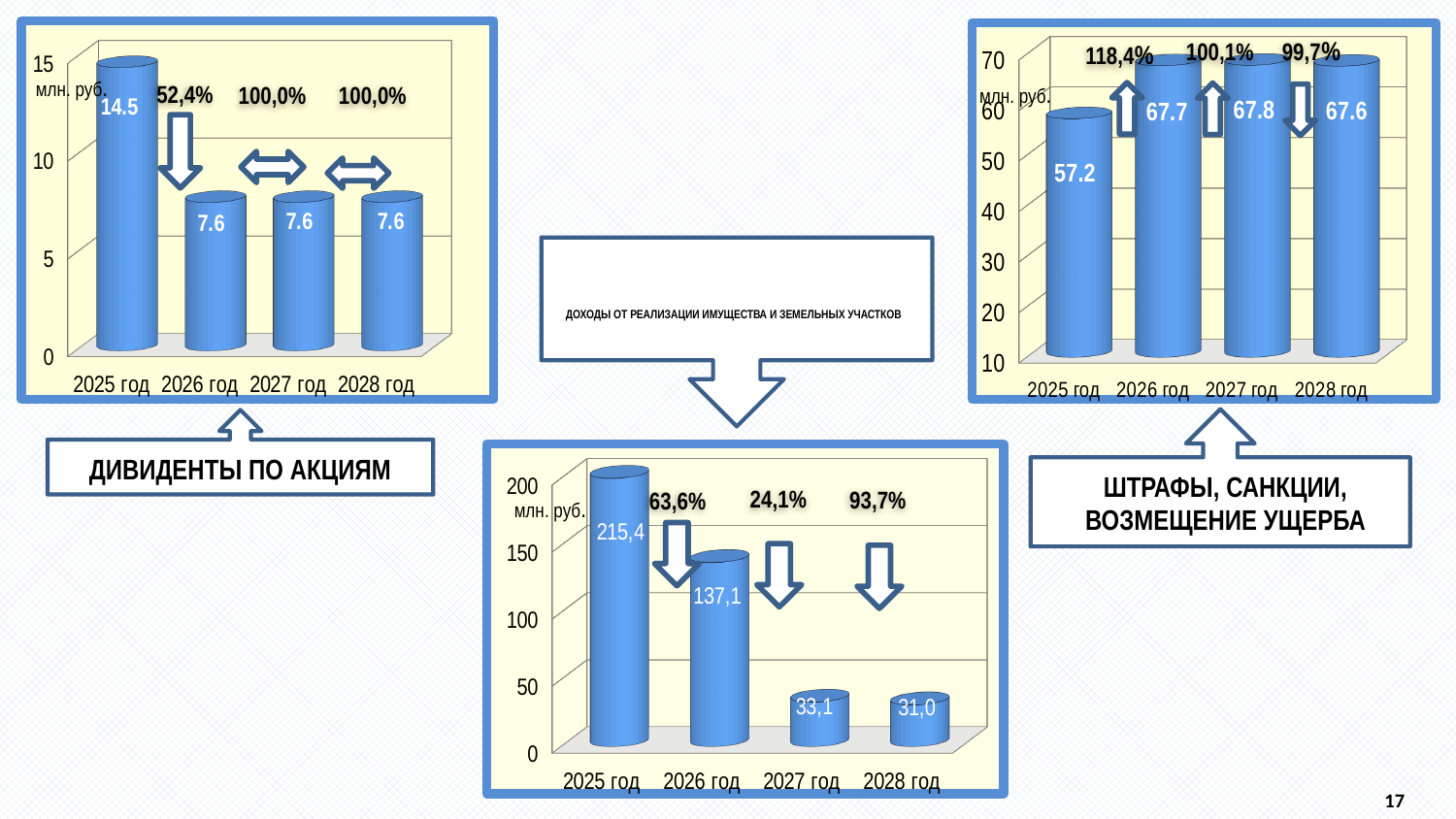
In the 'ДОХОДЫ ОТ РЕАЛИЗАЦИИ ИМУЩЕСТВА И ЗЕМЕЛЬНЫХ УЧАСТКОВ' chart, do the values rise or fall from 2025 год to 2028 год? fall In the 'ШТРАФЫ, САНКЦИИ, ВОЗМЕЩЕНИЕ УЩЕРБА' chart, what is the value for 2025 год? 57.2 In the 'ШТРАФЫ, САНКЦИИ, ВОЗМЕЩЕНИЕ УЩЕРБА' chart, which is larger, the value for 2025 год or 2026 год? 2026 год In the 'ДИВИДЕНТЫ ПО АКЦИЯМ' chart, what is the value for 2027 год? 7.6 In the 'ДИВИДЕНТЫ ПО АКЦИЯМ' chart, which year has the highest value? 2025 год How many years are shown on the x axis of the 'ШТРАФЫ, САНКЦИИ, ВОЗМЕЩЕНИЕ УЩЕРБА' chart? 4 In the 'ДИВИДЕНТЫ ПО АКЦИЯМ' chart, what is the value for 2025 год? 14.5 In the 'ДОХОДЫ ОТ РЕАЛИЗАЦИИ ИМУЩЕСТВА И ЗЕМЕЛЬНЫХ УЧАСТКОВ' chart, what is the value for 2026 год? 137,1 In the 'ДИВИДЕНТЫ ПО АКЦИЯМ' chart, what is the difference between the 2025 год and 2026 год values? 6.9 What kind of chart is the 'ДИВИДЕНТЫ ПО АКЦИЯМ' chart? bar chart In the 'ДОХОДЫ ОТ РЕАЛИЗАЦИИ ИМУЩЕСТВА И ЗЕМЕЛЬНЫХ УЧАСТКОВ' chart, what is the difference between the 2025 год and 2026 год values? 78,3 In the 'ДОХОДЫ ОТ РЕАЛИЗАЦИИ ИМУЩЕСТВА И ЗЕМЕЛЬНЫХ УЧАСТКОВ' chart, which year has the lowest value? 2028 год